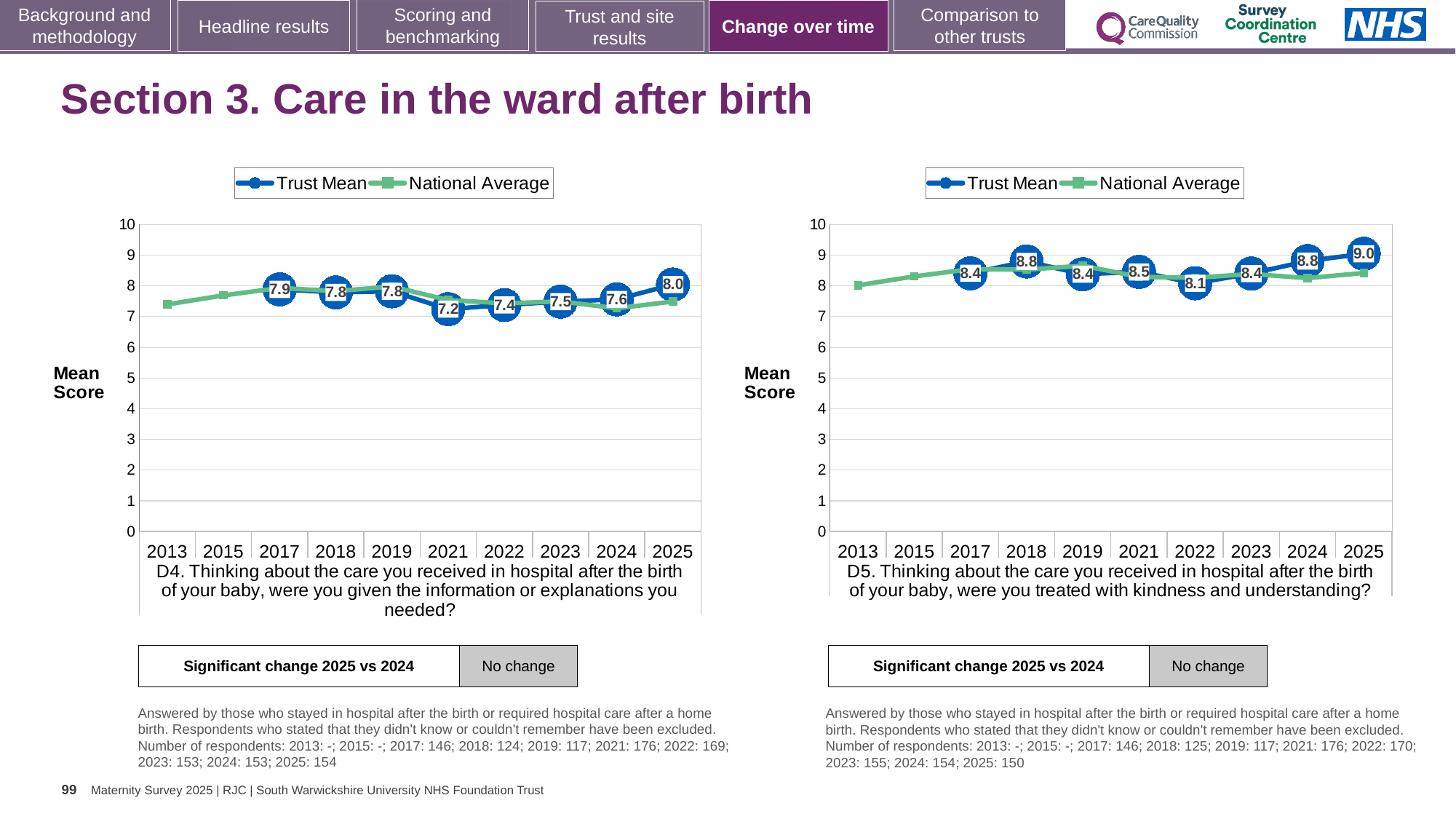
How many series does the legend of the D4 chart on the left list? 2 In the D5 chart on the right, what is the difference between the Trust Mean scores for 2025 and 2022? 0.9 How many years are shown on the x axis of the D5 chart on the right? 10 In the D4 chart on the left, which year has the lowest Trust Mean score? 2021 What type of chart is the D5 chart on the right? line chart In the D5 chart on the right, which year has the highest Trust Mean score? 2025 In the D4 chart on the left, what is the Trust Mean score for 2021? 7.2 In the D5 chart on the right, what is the Trust Mean score for 2022? 8.1 In the D5 chart on the right, is the Trust Mean score for 2018 higher or lower than for 2019? higher In the D4 chart on the left, what is the Trust Mean score for 2025? 8.0 In the D4 chart on the left, what is the difference between the Trust Mean scores for 2025 and 2021? 0.8 In the D4 chart on the left, is the National Average value for 2013 greater or less than 8? less